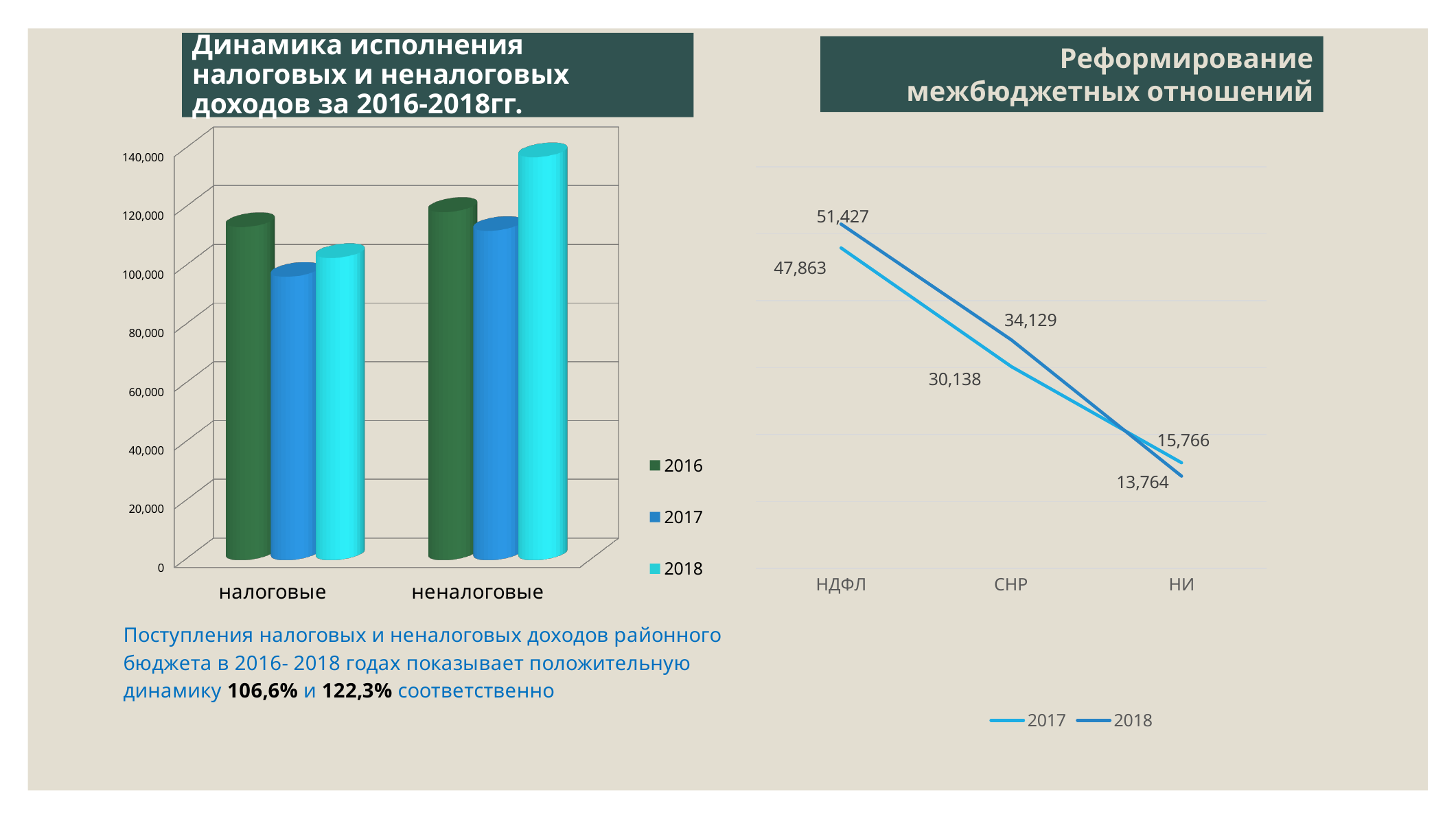
On the chart titled 'Реформирование межбюджетных отношений', what is the 2017 value for НИ? 15,766 On the chart titled 'Реформирование межбюджетных отношений', what is the 2018 value for НИ? 13,764 On the chart titled 'Реформирование межбюджетных отношений', do the 2018 values rise or fall from НДФЛ to НИ? fall On the chart titled 'Реформирование межбюджетных отношений', what is the 2017 value for СНР? 30,138 On the chart titled 'Реформирование межбюджетных отношений', which category has the highest 2018 value? НДФЛ On the left bar chart, is the 2018 value for неналоговые greater or less than 120,000? greater On the left bar chart, how many categories are shown on the x axis? 2 On the chart titled 'Реформирование межбюджетных отношений', how many series does the legend list? 2 What kind of chart is the one on the left, titled 'Динамика исполнения налоговых и неналоговых доходов за 2016-2018гг.'? bar chart On the chart titled 'Реформирование межбюджетных отношений', what is the difference between the 2018 and 2017 values for НДФЛ? 3,564 On the chart titled 'Реформирование межбюджетных отношений', which is larger for НИ: the 2017 value or the 2018 value? 2017 On the chart titled 'Реформирование межбюджетных отношений', what is the 2018 value for НДФЛ? 51,427